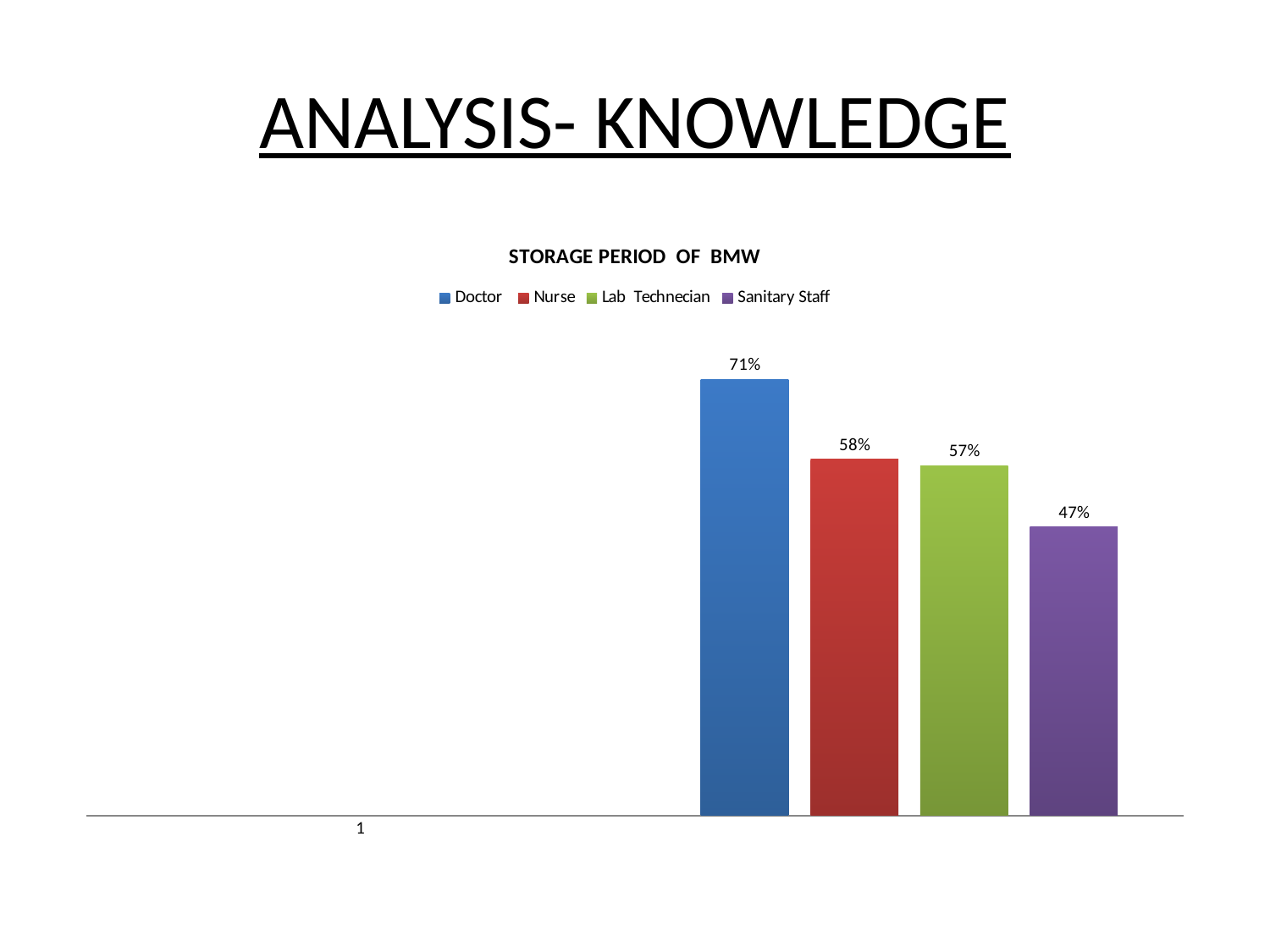
What is the value for Nurse? 58% What is the difference between the Doctor and Sanitary Staff values? 24% How many series does the legend list? 4 Which series has the lowest value? Sanitary Staff Which series has the highest value? Doctor What kind of chart is shown? Bar chart What is the value for Sanitary Staff? 47% Which is larger, the value for Doctor or the value for Nurse? Doctor What is the title of the chart? STORAGE PERIOD OF BMW What is the difference between the Nurse and Lab Technecian values? 1% What is the value for Lab Technecian? 57% What is the value for Doctor? 71%